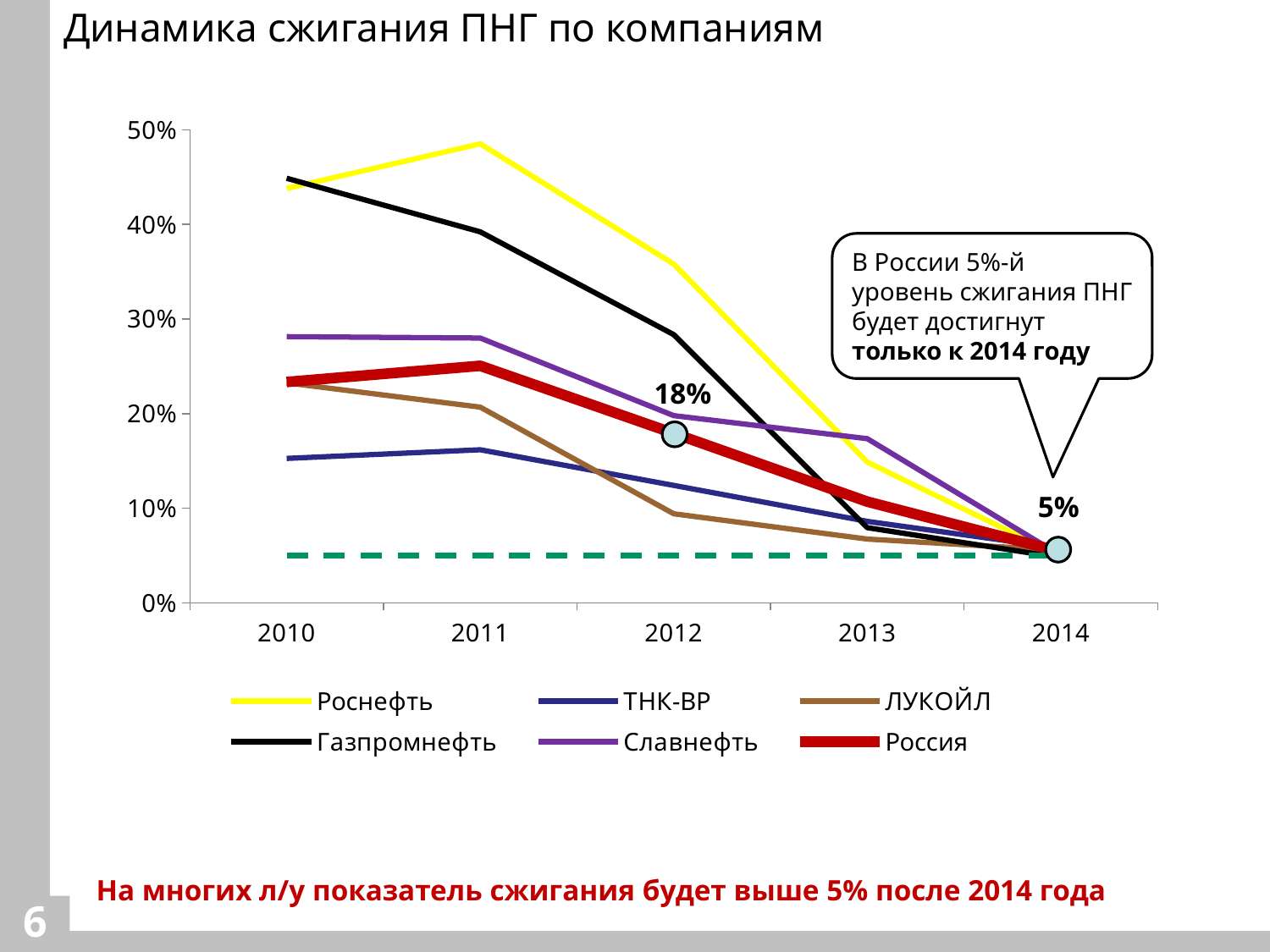
What kind of chart is shown on the slide? line chart How many years are shown on the x axis? 5 Which is larger in 2010, the value for Славнефть or the value for ТНК-ВР? Славнефть Which company has the lowest value in 2010? ТНК-ВР What is the value for Россия in 2012? 18% Is the value for Газпромнефть in 2013 greater or less than 10%? less Which company has the highest value in 2011? Роснефть By how much does the value for Россия fall from 2012 to 2014? 13% How many series does the legend list? 6 Does the value for Газпромнефть rise or fall from 2010 to 2014? fall Is the value for Роснефть in 2011 greater or less than 40%? greater What is the value for Россия in 2014? 5%